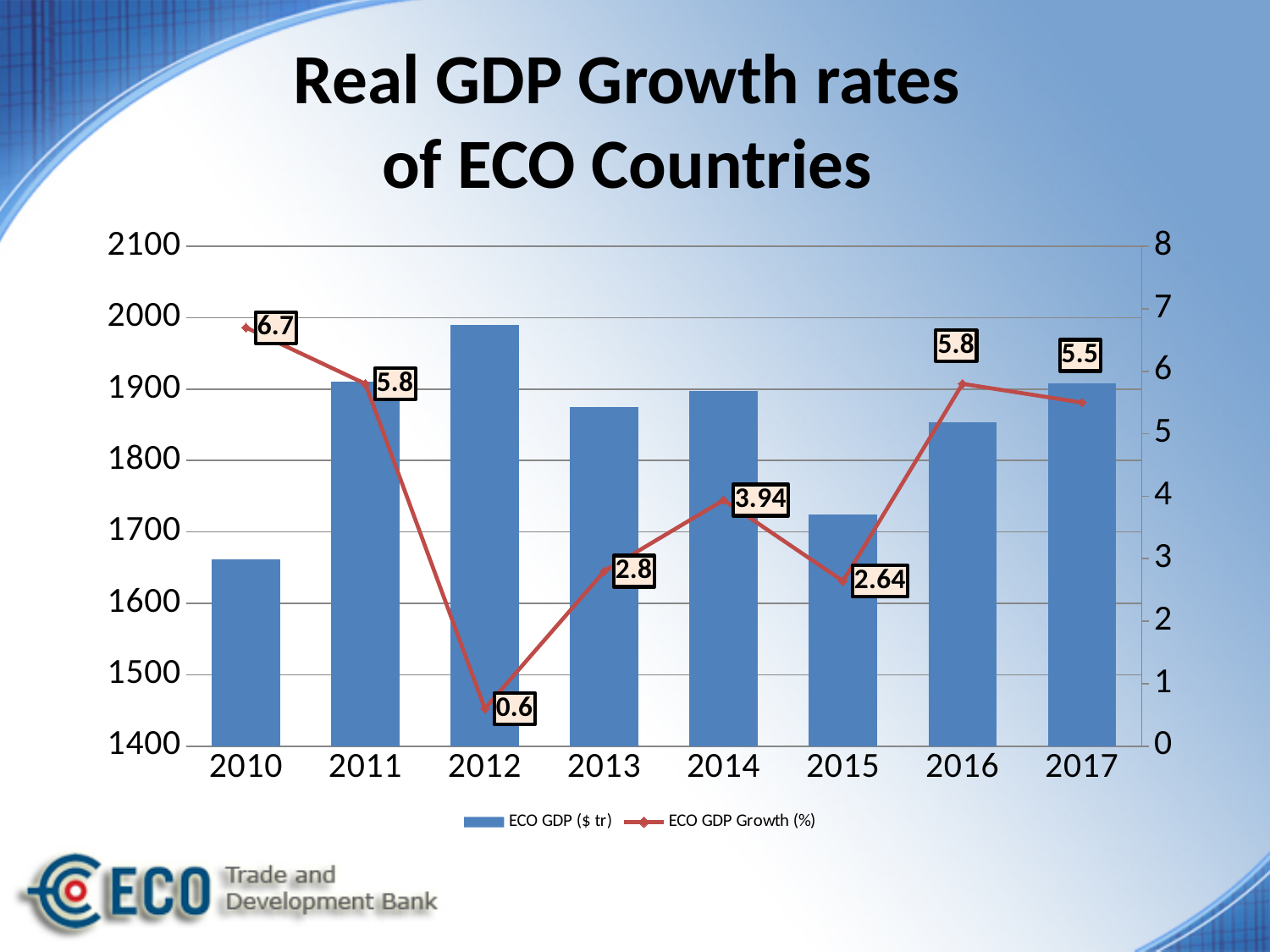
What is the ECO GDP Growth (%) value for 2015? 2.64 In which year is the ECO GDP Growth (%) highest? 2010 What is the ECO GDP Growth (%) value for 2010? 6.7 Which year has the higher ECO GDP Growth (%), 2013 or 2014? 2014 How many series does the legend list? 2 How many years are shown on the x axis of the chart? 8 In which year is the ECO GDP Growth (%) lowest? 2012 In which year is the ECO GDP ($ tr) bar the tallest? 2012 What is the ECO GDP Growth (%) value for 2014? 3.94 In which year is the ECO GDP ($ tr) bar the shortest? 2010 What is the difference between the ECO GDP Growth (%) values for 2010 and 2012? 6.1 Is the ECO GDP ($ tr) value for 2015 greater or less than 1800? less